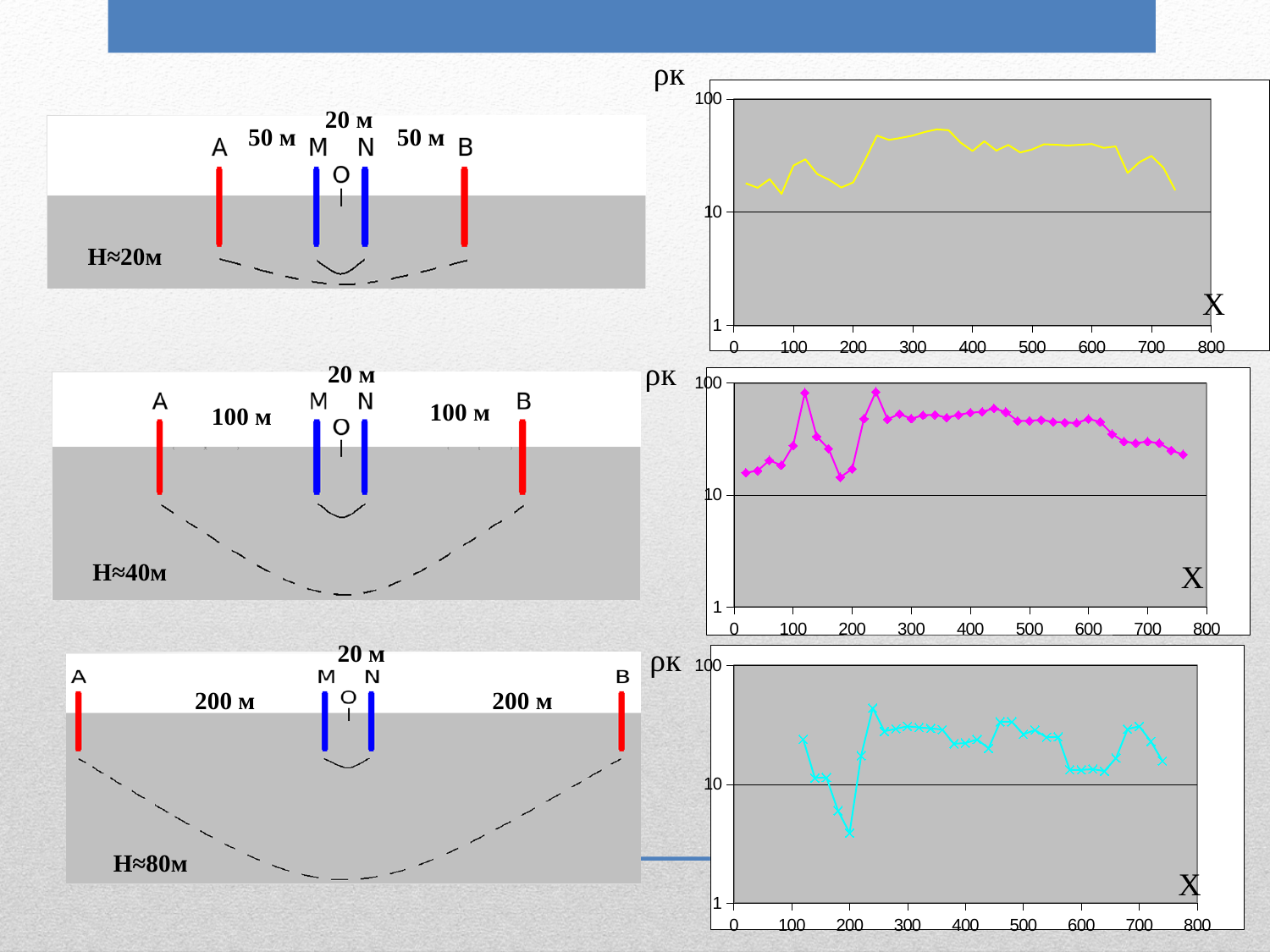
In the middle chart, which is larger: the value at X = 120 or the value at X = 180? X = 120 In the bottom chart, do the values rise or fall between X = 100 and X = 200? fall In the bottom chart, which is larger: the value at X = 200 or the value at X = 240? X = 240 What is the label on the vertical axis of the charts? ρк In the bottom chart, is the value at X = 200 greater or less than 10? less How many charts are shown on the slide? 3 In the top chart, is the value at X = 400 greater or less than 10? greater What colour is the line in the middle chart? magenta In the bottom chart, at which X value does the line reach its lowest point? 200 In the bottom chart, is the value at X = 240 greater or less than 10? greater What kind of chart is the top chart on the slide? line chart